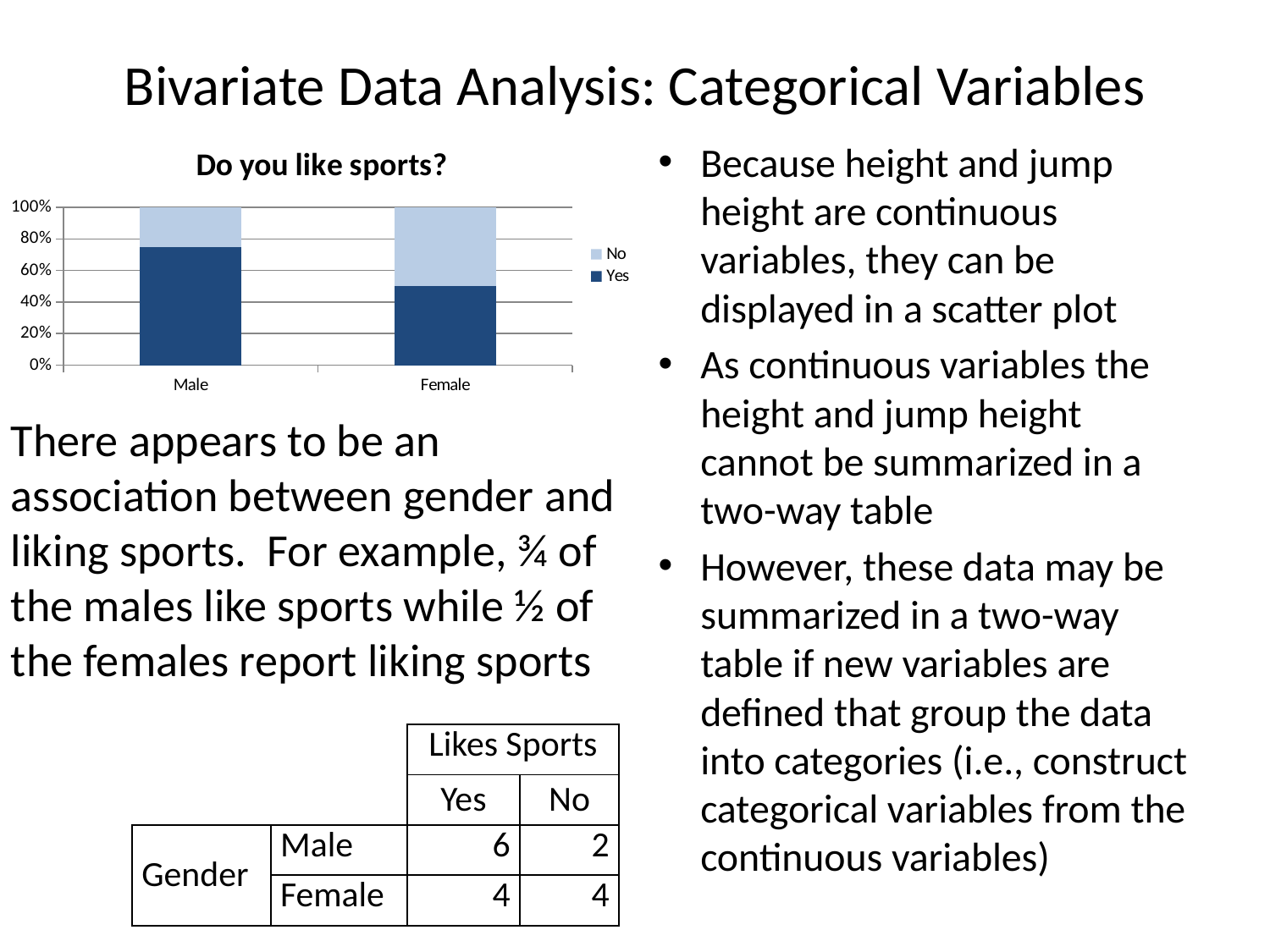
Is the No share for Male greater or less than 40%? less Is the Yes share for Female greater or less than 60%? less What kind of chart is shown on the slide? bar chart Which category has the larger Yes share, Male or Female? Male What is the title of the chart? Do you like sports? Is the Yes share for Male greater or less than 60%? greater What are the two series listed in the chart's legend? No and Yes Which category has the larger No share, Male or Female? Female Which category has the highest Yes share? Male How many categories are shown on the x axis of the chart? 2 How many series does the chart's legend list? 2